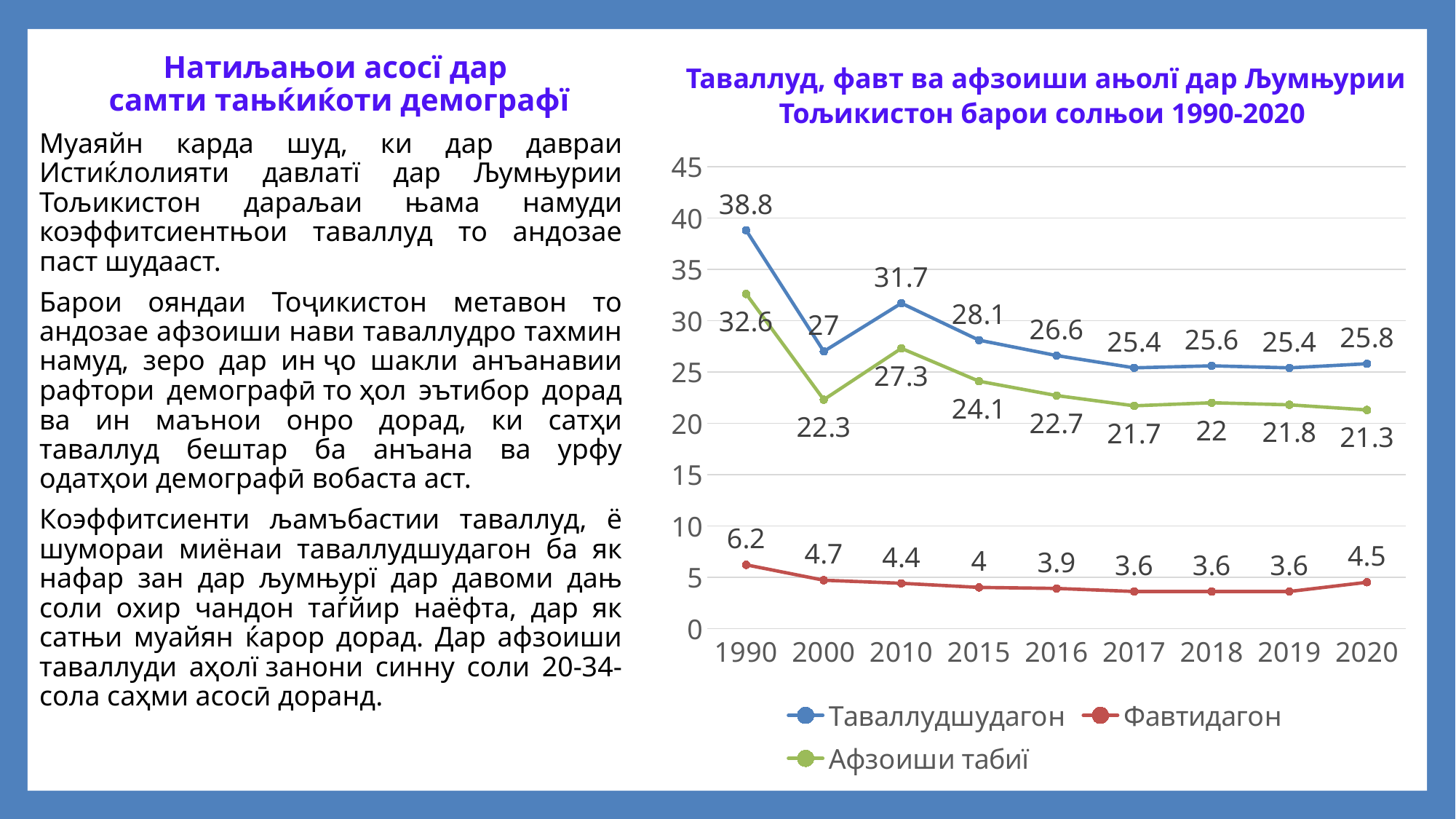
In which year is the Таваллудшудагон value highest? 1990 Does the Таваллудшудагон series generally rise or fall from 1990 to 2020? fall How many series does the legend list? 3 In which year is the Афзоиши табиї value lowest? 2020 What is the value for Афзоиши табиї in 2010? 27.3 What is the difference between the Таваллудшудагон value in 1990 and in 2000? 11.8 How many years are shown on the x axis? 9 What is the value for Фавтидагон in 2020? 4.5 What type of chart is shown on the slide? line chart Which is larger: the Фавтидагон value in 1990 or in 2000? 1990 Which series is shown in red in the legend? Фавтидагон What is the value for Таваллудшудагон in 1990? 38.8